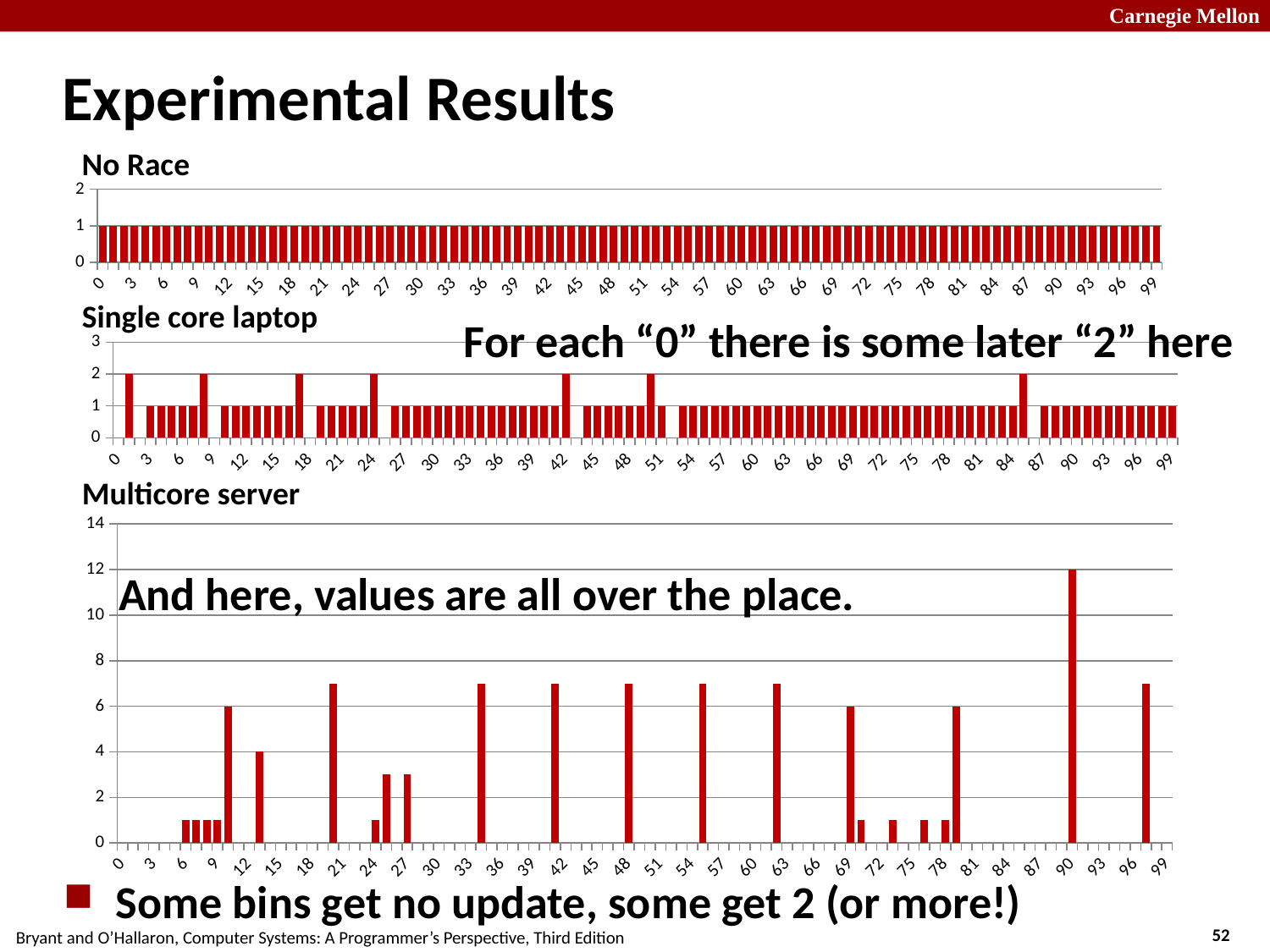
In the "No Race" chart, what is the value for category 50? 1 In the "No Race" chart, do the values rise, fall, or stay flat across the x axis? stay flat How many charts are shown on the slide? 3 In the "Multicore server" chart, is the value for category 90 greater or less than 10? greater In the "Multicore server" chart, what is the value of the tallest bar? 12 In the "Single core laptop" chart, what is the highest value reached by any bar? 2 In the "Multicore server" chart, which category has the tallest bar? 90 In the "Multicore server" chart, what is the highest tick shown on the y axis? 14 What kind of chart is the "Multicore server" chart? bar chart In the "Single core laptop" chart, what is the lowest value reached by any bar? 0 What kind of chart is the "No Race" chart at the top of the slide? bar chart What is the title of the bottom chart on the slide? Multicore server